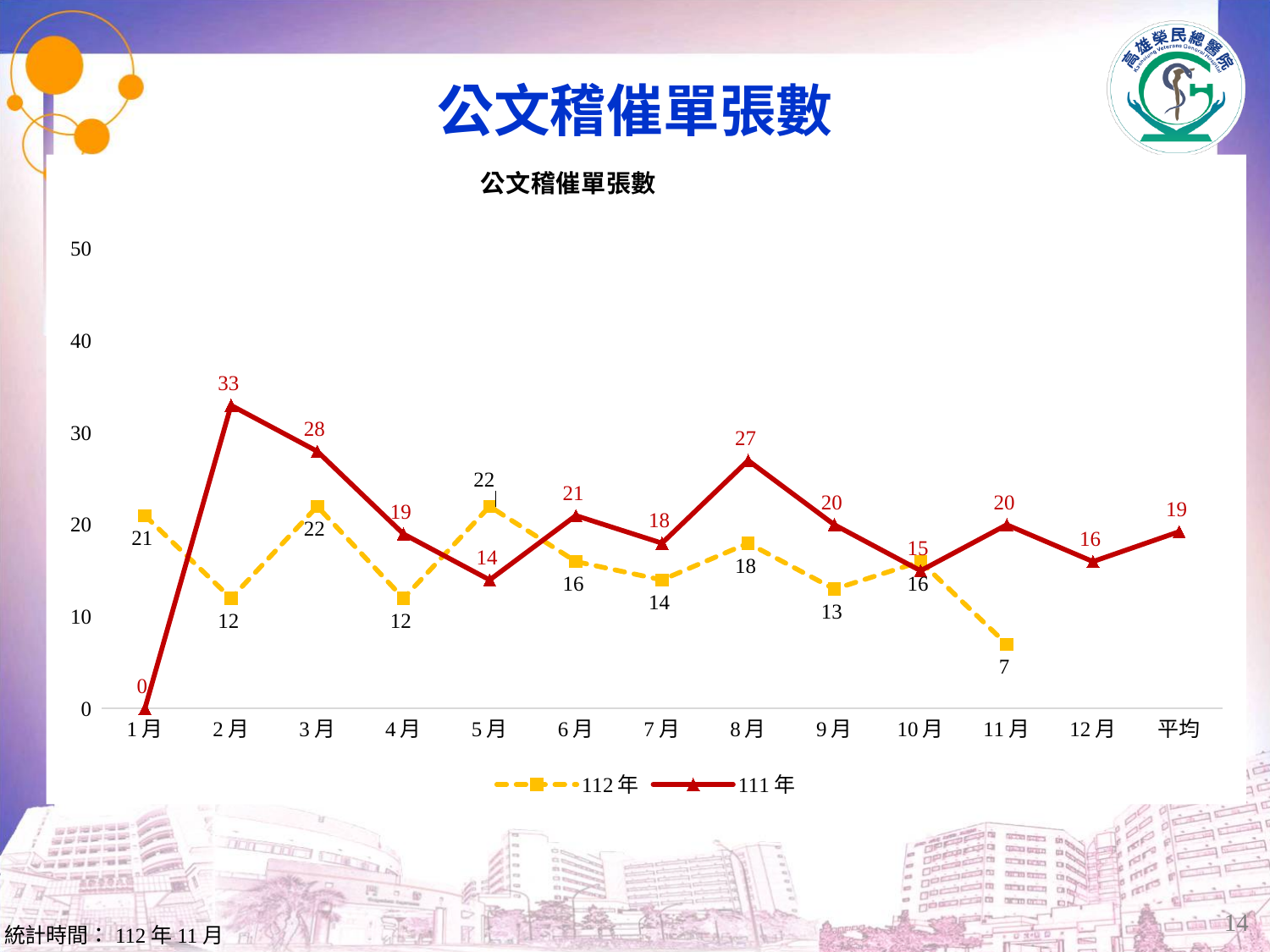
How many series does the legend list? 2 What is the difference between 111年 and 112年 in 8月? 9 What is the value for 112年 in 11月? 7 In which month is the 112年 series lowest? 11月 In which month is the 111年 series highest? 2月 What kind of chart is shown on the slide? line chart Which series has the larger value in 1月, 112年 or 111年? 112年 Which series is drawn with a dashed line? 112年 Is the value for 111年 in 3月 greater or less than 20? greater What is the 平均 value for 111年? 19 How many categories are shown on the x axis? 13 What is the value for 111年 in 2月? 33